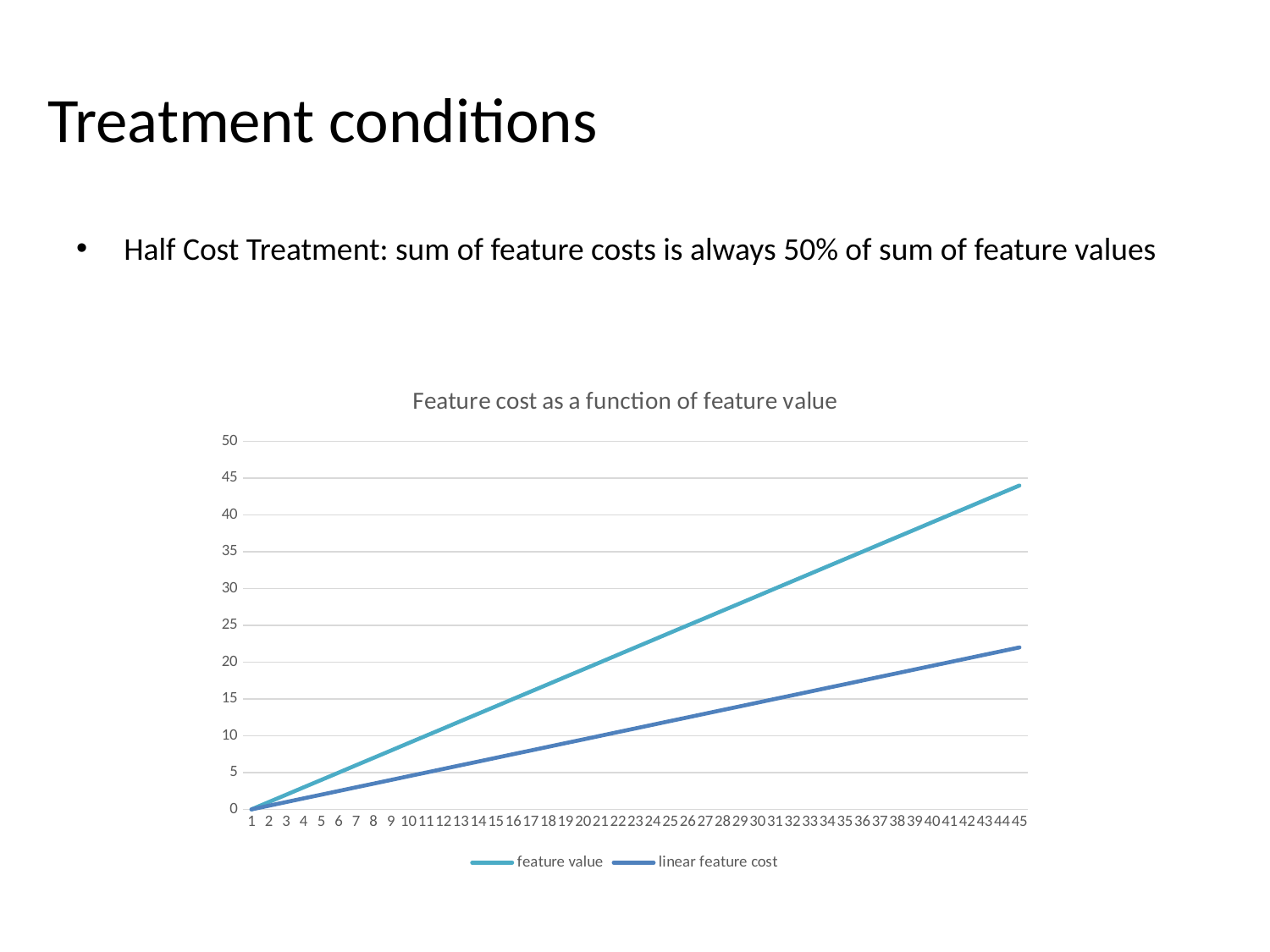
What are the two series named in the legend? feature value, linear feature cost Is the linear feature cost at x = 30 greater or less than 20? less What kind of chart is shown on the slide? line chart Do the values of the feature value series rise or fall along the x axis? rise How many points are plotted along the x axis for each series? 45 Is the feature value at x = 45 greater or less than 40? greater What is the title of the chart? Feature cost as a function of feature value Which series reaches the higher value at x = 45, feature value or linear feature cost? feature value Is the linear feature cost at x = 45 greater or less than 20? greater How many series does the legend list? 2